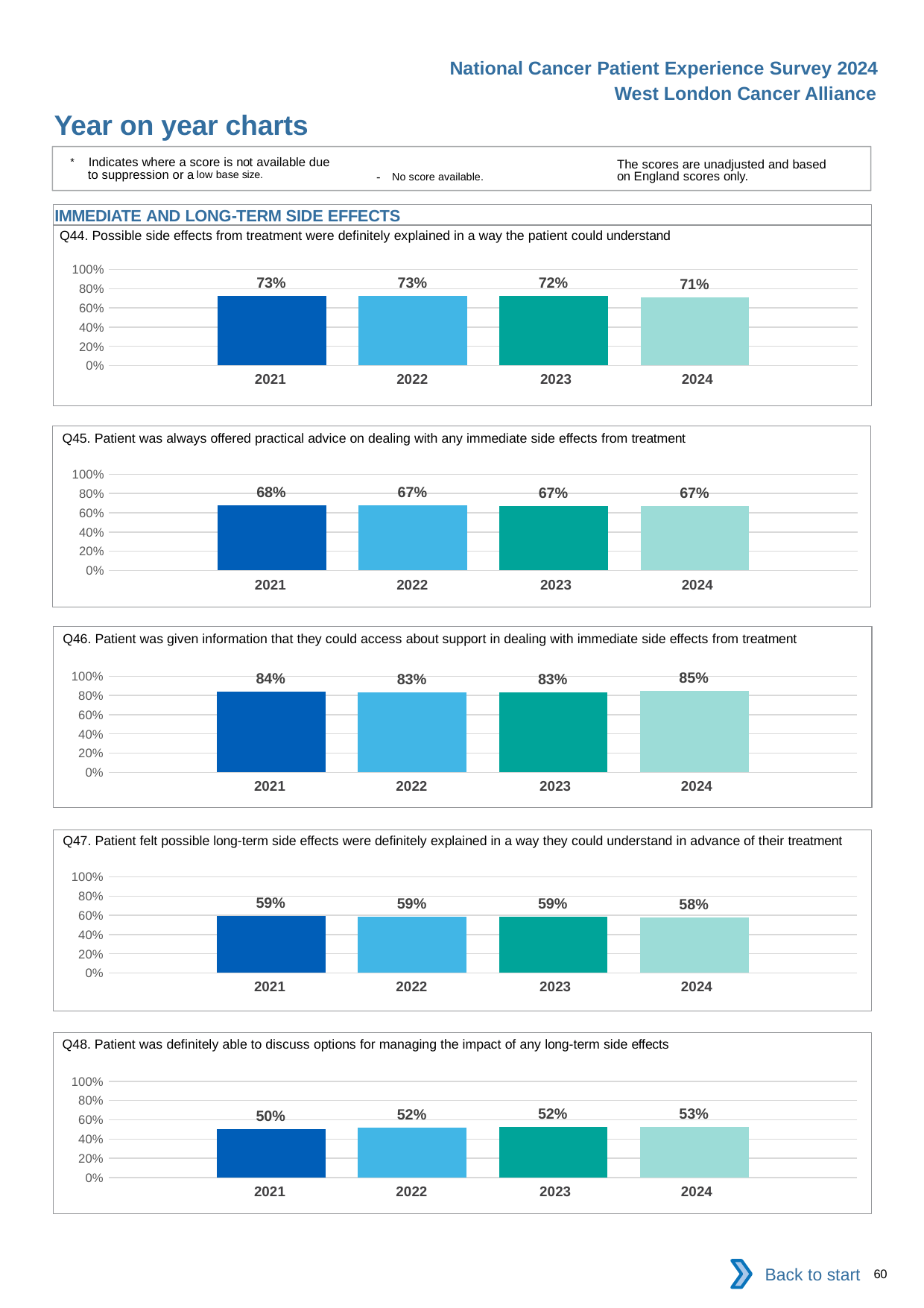
In the Q44 chart, what is the value for 2024? 71% How many years are shown in the Q44 chart? 4 In the Q46 chart, which year has the highest value? 2024 In the Q47 chart, is the value for 2021 greater or less than 60%? less In the Q46 chart, what is the value for 2022? 83% In the Q44 chart, which year has the lowest value? 2024 In the Q48 chart, which is larger, the value for 2021 or the value for 2024? 2024 In the Q45 chart, what is the difference between the 2021 and 2024 values? 1% In the Q48 chart, what is the value for 2021? 50% In the Q48 chart, what is the difference between the 2024 and 2021 values? 3% In the Q45 chart, what is the value for 2021? 68% In the Q47 chart, what is the value for 2024? 58%